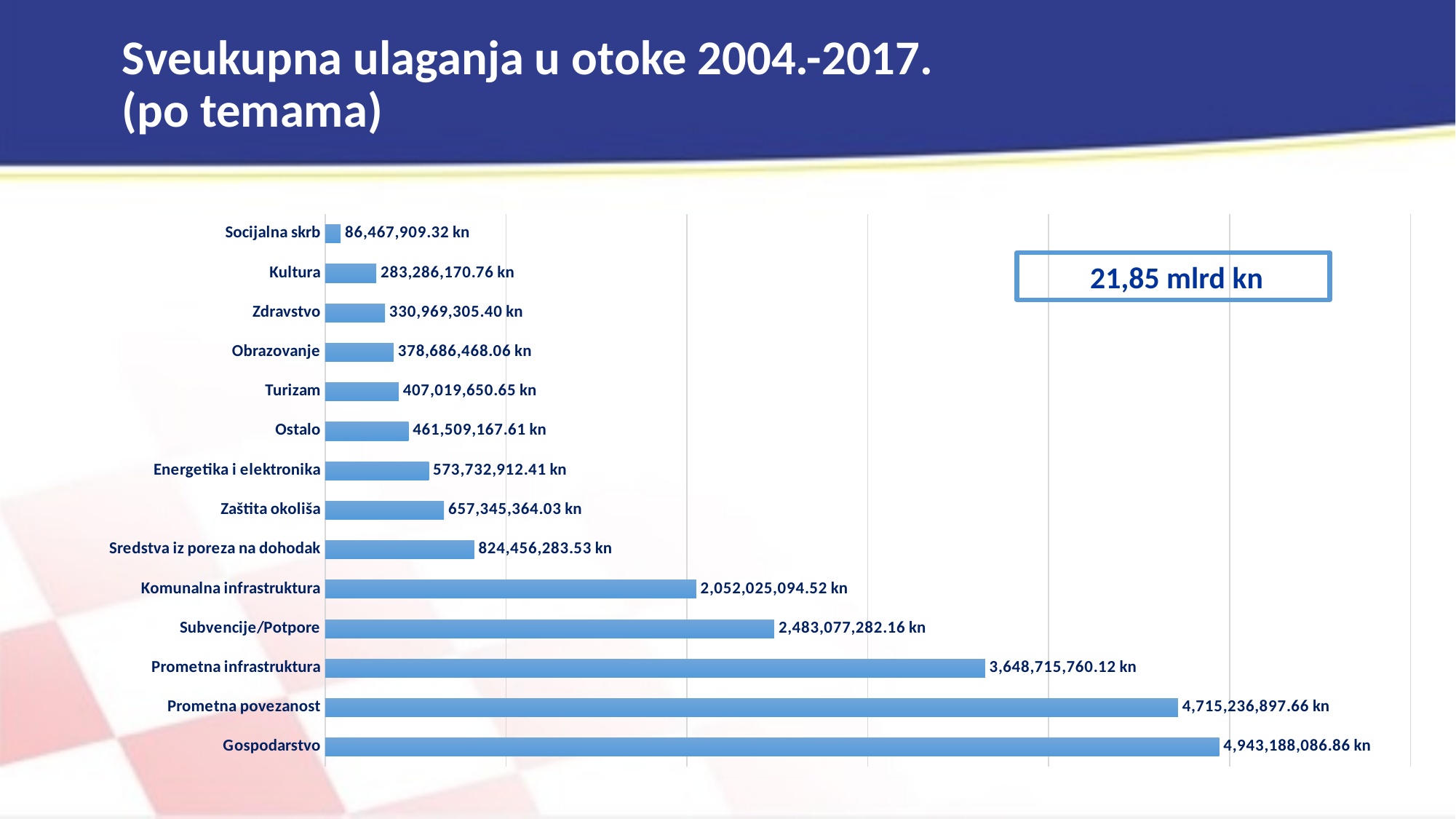
Which category has the lowest value? Socijalna skrb What is the difference between Kultura and Socijalna skrb? 196,818,261.44 kn Which category has the highest value? Gospodarstvo What is the difference between Gospodarstvo and Prometna povezanost? 227,951,189.20 kn What is the value for Zaštita okoliša? 657,345,364.03 kn How many categories are shown in the chart? 14 Which is larger, Subvencije/Potpore or Komunalna infrastruktura? Subvencije/Potpore What total amount is shown in the box next to the chart? 21,85 mlrd kn What is the value for Turizam? 407,019,650.65 kn What is the value for Komunalna infrastruktura? 2,052,025,094.52 kn What is the value for Gospodarstvo? 4,943,188,086.86 kn What kind of chart is shown on the slide? Bar chart